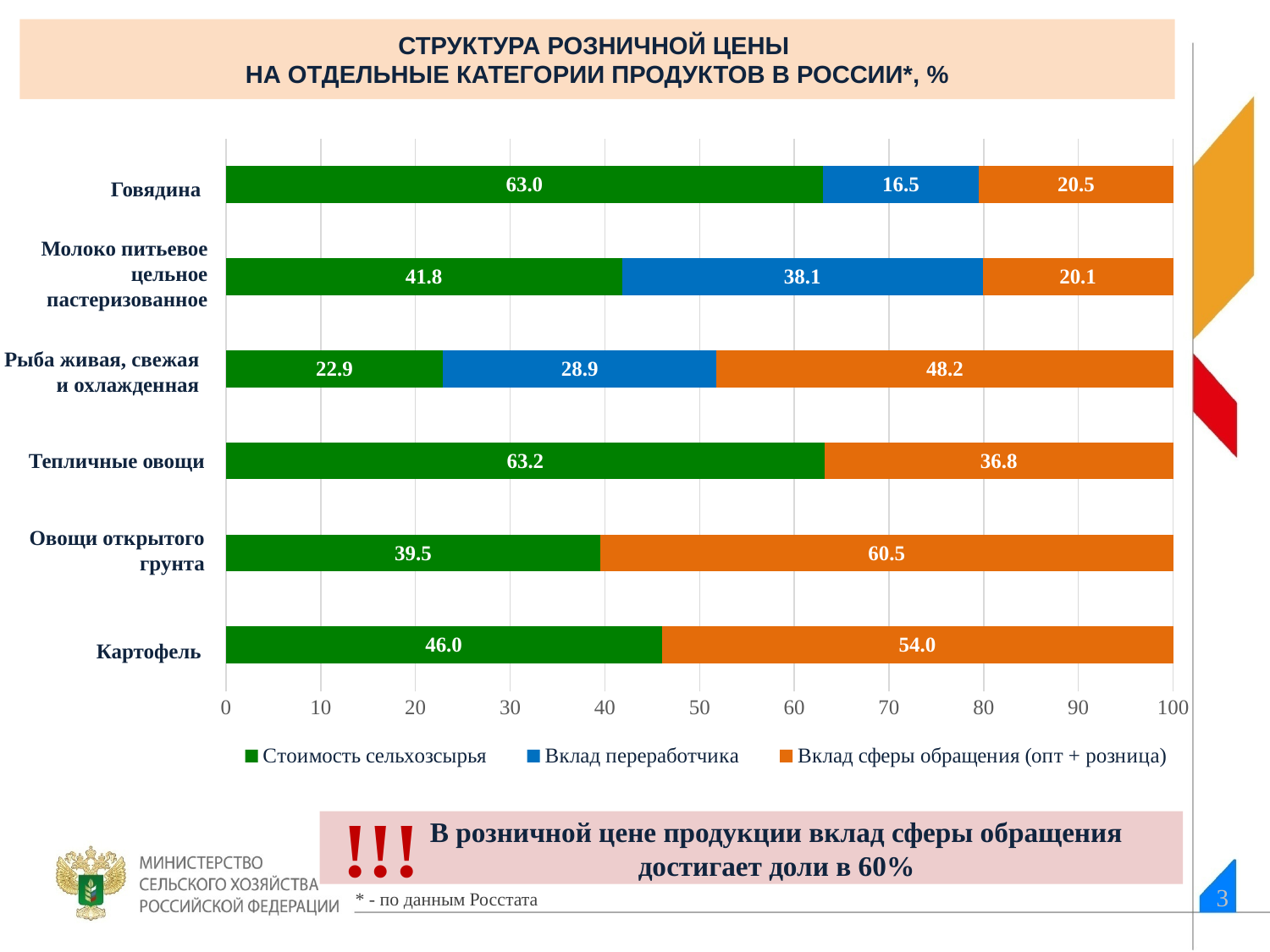
How many product categories are plotted on the chart? 6 What is the value of "Вклад переработчика" for "Молоко питьевое цельное пастеризованное"? 38.1 What is the total of the stacked bar for "Говядина"? 100.0 Which is larger for "Тепличные овощи": "Стоимость сельхозсырья" or "Вклад сферы обращения (опт + розница)"? Стоимость сельхозсырья What is the value of "Вклад сферы обращения (опт + розница)" for "Рыба живая, свежая и охлажденная"? 48.2 What is the value of "Стоимость сельхозсырья" for "Говядина"? 63.0 What kind of chart is shown on the slide? Stacked bar chart Which category has the lowest value for "Стоимость сельхозсырья"? Рыба живая, свежая и охлажденная How many series does the legend list? 3 Which category has the highest value for "Вклад сферы обращения (опт + розница)"? Овощи открытого грунта Which colour represents "Вклад переработчика" in the legend? Blue What is the difference between "Вклад сферы обращения (опт + розница)" and "Стоимость сельхозсырья" for "Картофель"? 8.0